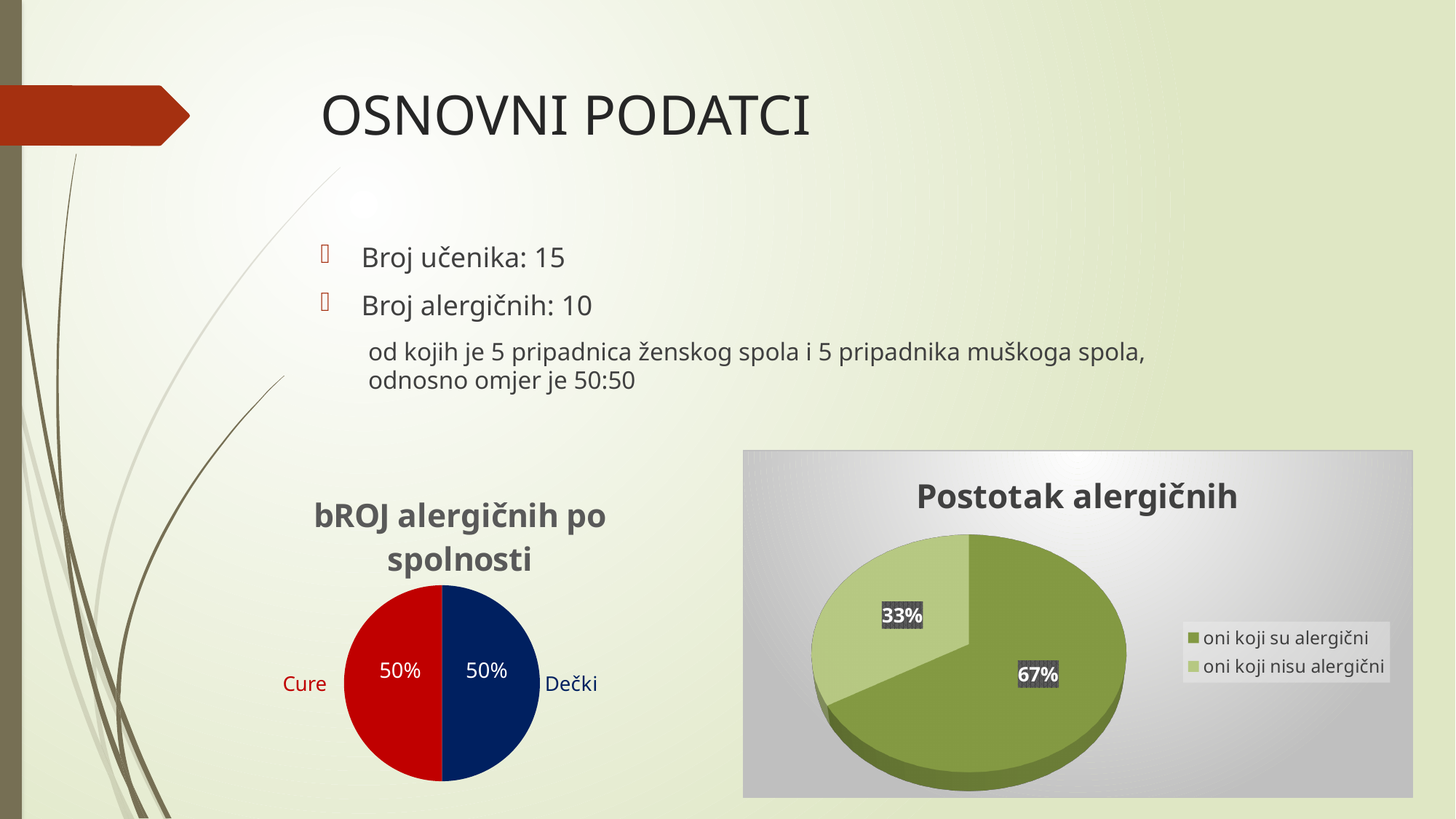
In the chart titled "bROJ alergičnih po spolnosti", what share of the pie is labelled "Dečki"? 50% In the chart titled "Postotak alergičnih", what is the difference in percentage points between the two slices? 34 What kind of chart is the chart titled "Postotak alergičnih"? Pie chart In the chart titled "bROJ alergičnih po spolnosti", how many slices does the pie have? 2 In the chart titled "Postotak alergičnih", which slice is the largest? oni koji su alergični In the chart titled "Postotak alergičnih", how many entries does the legend list? 2 In the chart titled "bROJ alergičnih po spolnosti", what share of the pie is labelled "Cure"? 50% In the chart titled "Postotak alergičnih", which slice is the smallest? oni koji nisu alergični What kind of chart is the chart titled "bROJ alergičnih po spolnosti"? Pie chart In the chart titled "bROJ alergičnih po spolnosti", what colour is the "Cure" slice? Red In the chart titled "Postotak alergičnih", what share of the pie is "oni koji nisu alergični"? 33%